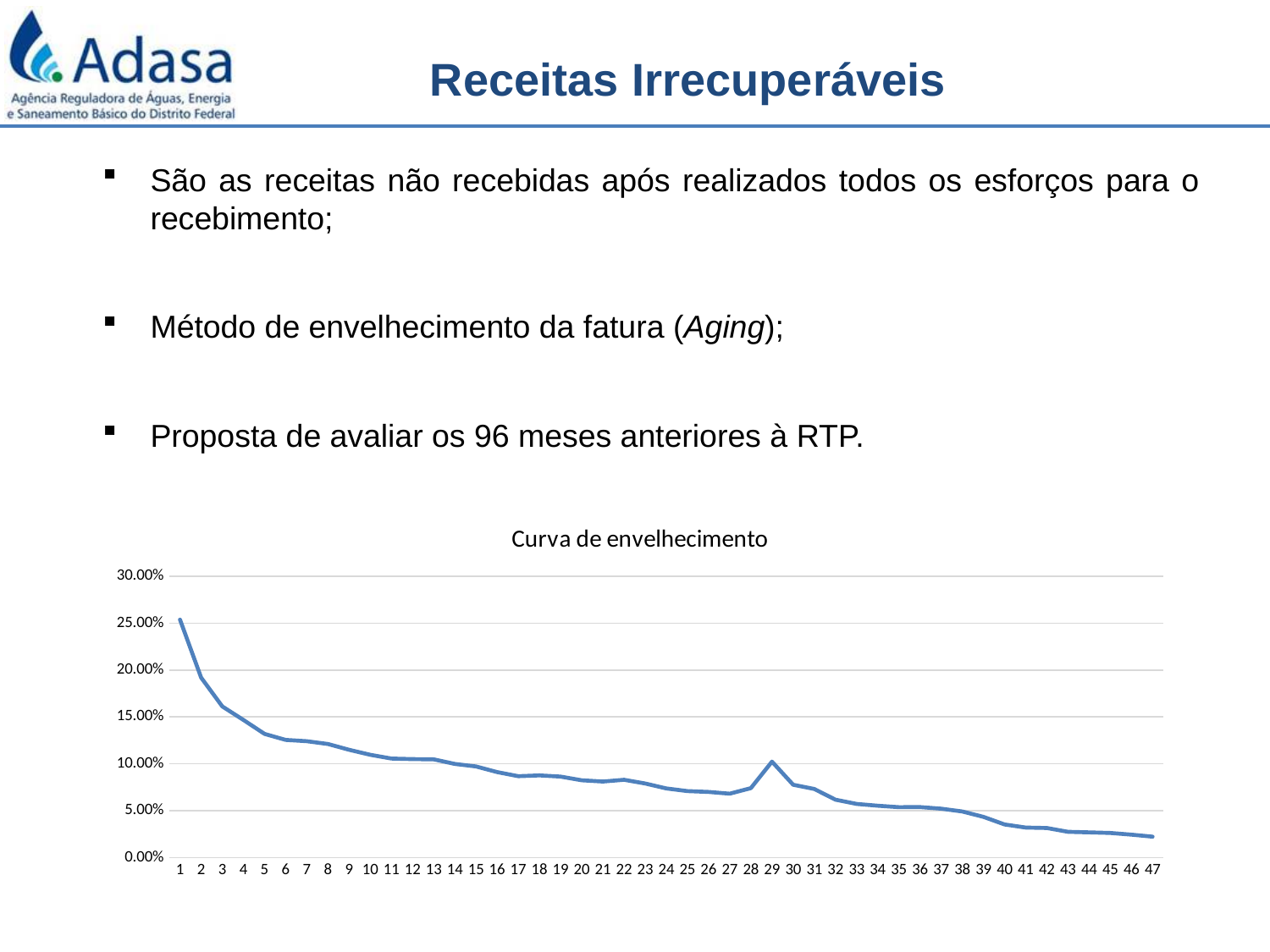
Is the value at point 47 greater or less than 5.00%? less At which x-axis point is the value lowest? 47 Is the value at point 5 greater or less than 10.00%? greater Which has the larger value, point 10 or point 30? 10 How many points are plotted along the x axis of the chart? 47 What is the title of the chart? Curva de envelhecimento Which has the larger value, point 28 or point 29? 29 Is the value at point 20 greater or less than 10.00%? less What kind of chart is shown on the slide? Line chart At which x-axis point is the value highest? 1 Do the values generally rise or fall as the x axis goes from 1 to 47? Fall